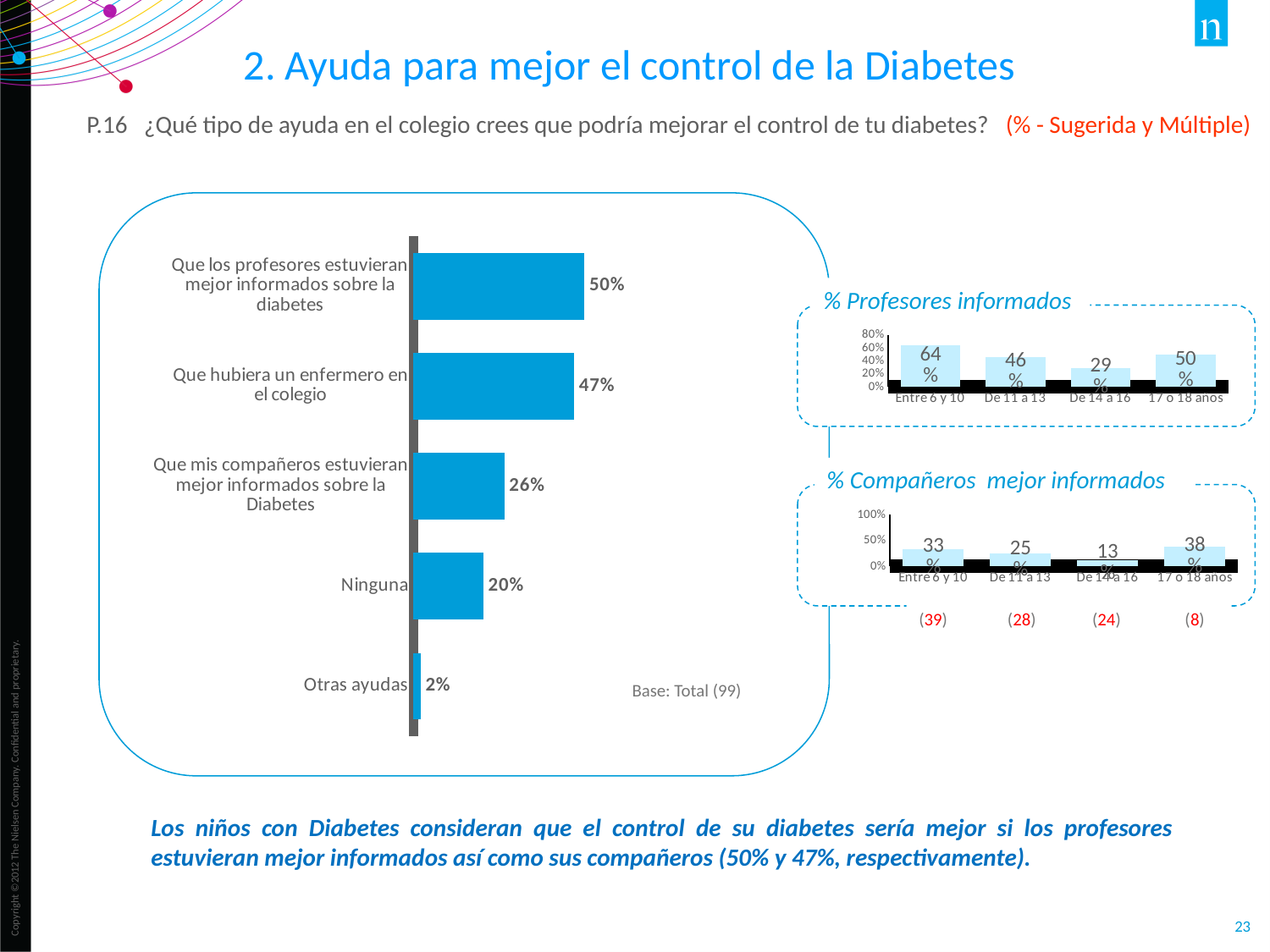
In the '% Profesores informados' chart, what is the value for 'Entre 6 y 10'? 64% In the main bar chart on the left, what is the value for 'Que hubiera un enfermero en el colegio'? 47% What kind of chart is the main chart on the left? Bar chart In the '% Profesores informados' chart, which age group has the lowest value? De 14 a 16 In the '% Compañeros mejor informados' chart, which age group has the highest value? 17 o 18 años In the main bar chart on the left, how many categories are shown? 5 In the '% Profesores informados' chart, what is the difference between 'Entre 6 y 10' and '17 o 18 años'? 14% In the '% Compañeros mejor informados' chart, what is the value for 'De 14 a 16'? 13% In the '% Compañeros mejor informados' chart, is the value for 'Entre 6 y 10' larger or smaller than the value for 'De 11 a 13'? Larger In the main bar chart on the left, what is the difference between the values for 'Que mis compañeros estuvieran mejor informados sobre la Diabetes' and 'Ninguna'? 6% In the main bar chart on the left, which category has the lowest value? Otras ayudas In the main bar chart on the left, which category has the highest value? Que los profesores estuvieran mejor informados sobre la diabetes